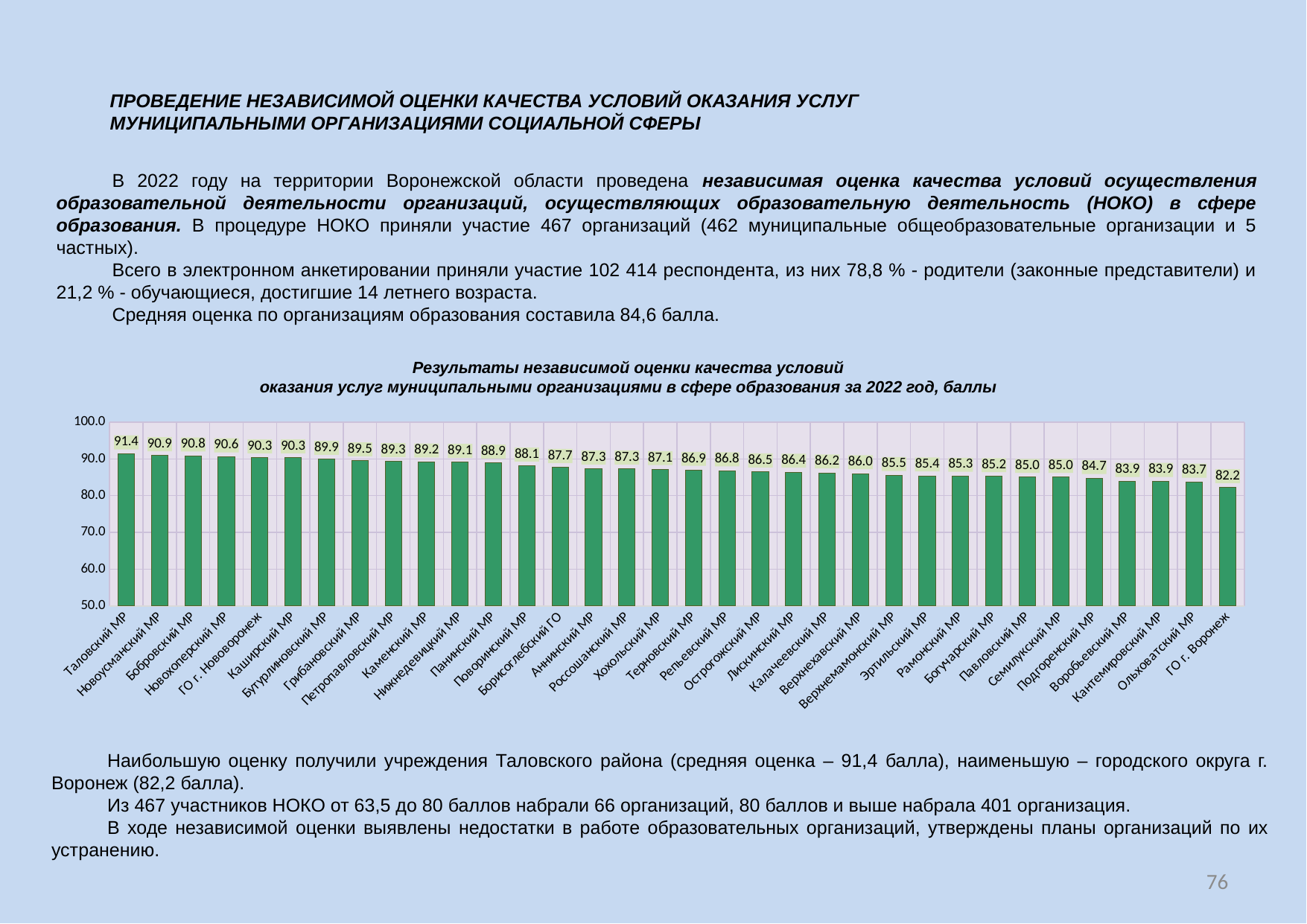
What is the difference between the values for Таловский МР and ГО г. Воронеж? 9.2 What value is shown for Таловский МР? 91.4 What kind of chart is shown? bar chart Is the value for Ольховатский МР greater or less than 90.0? less How many categories are shown on the chart? 34 What value is shown for Лискинский МР? 86.4 Which category has the lowest value? ГО г. Воронеж Which has a larger value, Панинский МР or Хохольский МР? Панинский МР What value is shown for Борисоглебский ГО? 87.7 What value is shown for ГО г. Воронеж? 82.2 Do the values rise or fall from left to right along the x axis? fall Which category has the highest value? Таловский МР